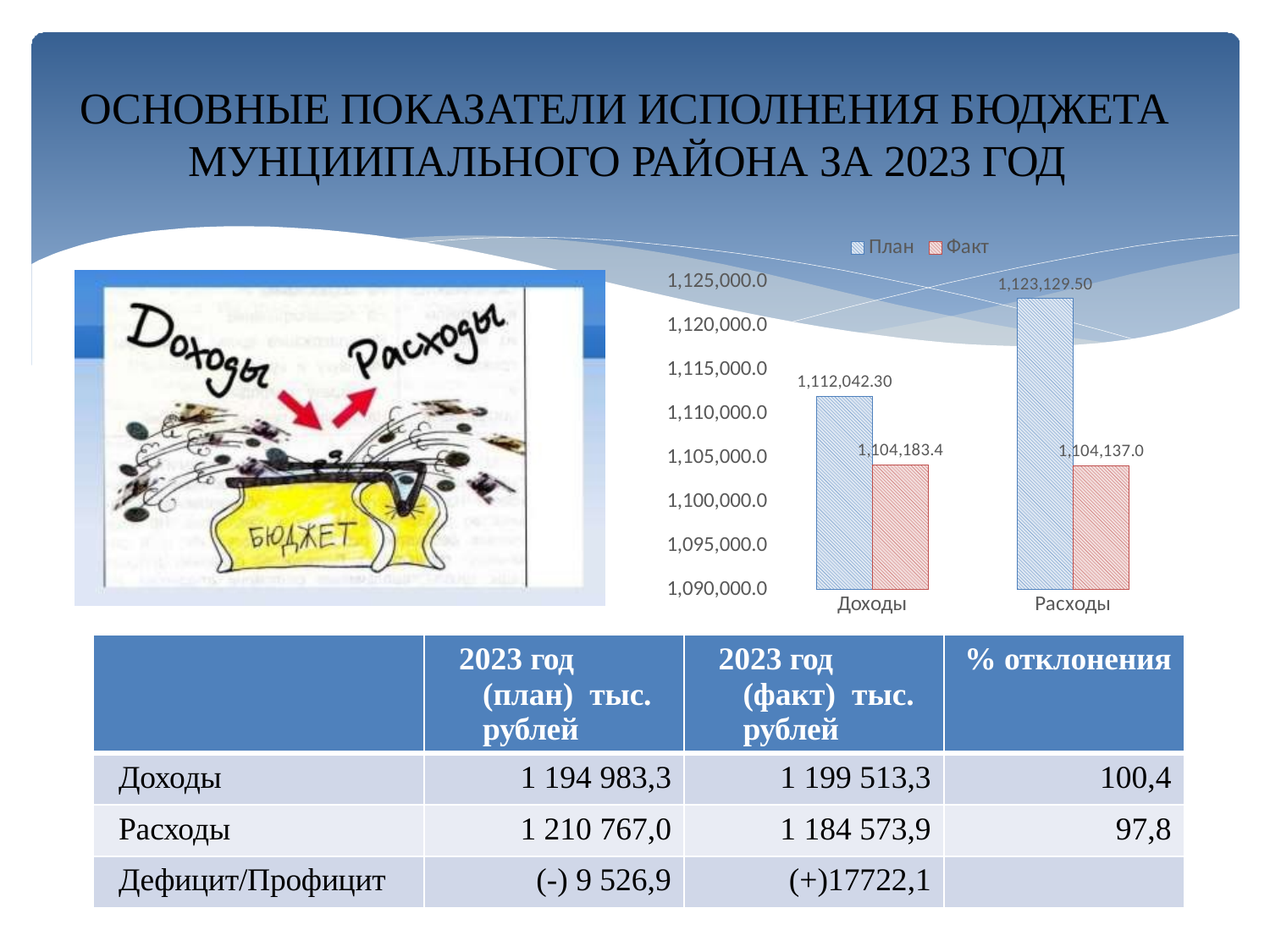
How many series does the chart legend list? 2 How many categories are shown on the x axis of the chart? 2 Is the План value for Расходы in the chart greater or less than 1,120,000.0? greater What is the Факт value for Доходы in the chart? 1,104,183.4 What type of chart is shown on the slide? bar chart What is the Факт value for Расходы in the chart? 1,104,137.0 What is the План value for Доходы in the chart? 1,112,042.30 Which category has the highest План value in the chart? Расходы What is the План value for Расходы in the chart? 1,123,129.50 Which is larger for Расходы in the chart, the План value or the Факт value? План What is the difference between the План values for Расходы and Доходы in the chart? 11,087.20 What is the difference between the План and Факт values for Доходы in the chart? 7,858.9